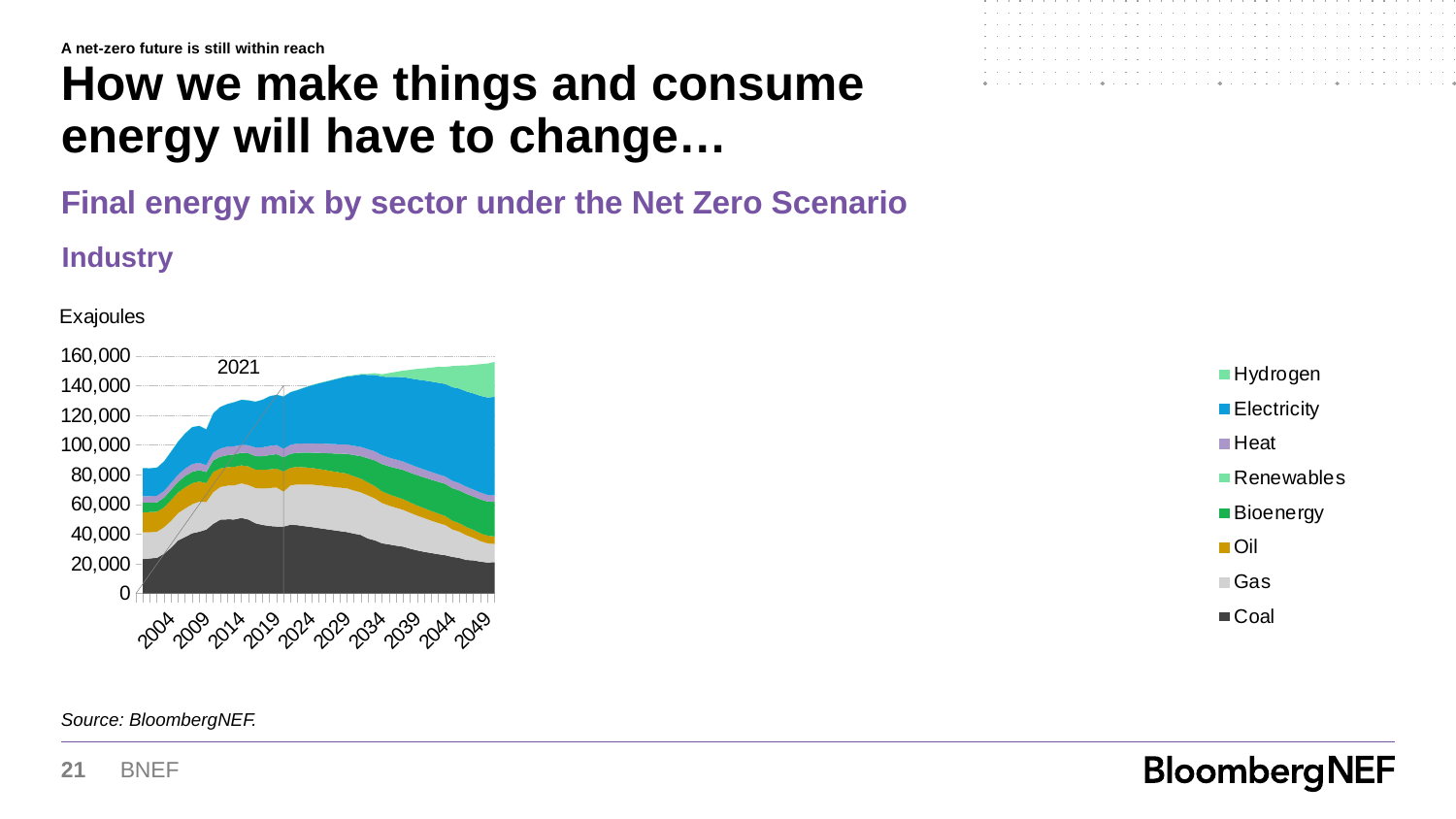
Which year is marked by the vertical line on the chart? 2021 Which series accounts for the largest share of the stack in 2049? Electricity Is the total final energy for Industry in 2049 greater or less than 140,000? greater How many year labels are shown on the x axis? 10 What kind of chart is shown on the slide? Stacked area chart Does the total stacked value rise or fall between 2004 and 2034? rises What unit is the y axis measured in? Exajoules Is the Coal value in 2014 greater or less than 40,000? greater In 2049, which is larger: Coal or Electricity? Electricity Does the Coal area rise or fall between 2024 and 2049? falls How many series does the legend list? 8